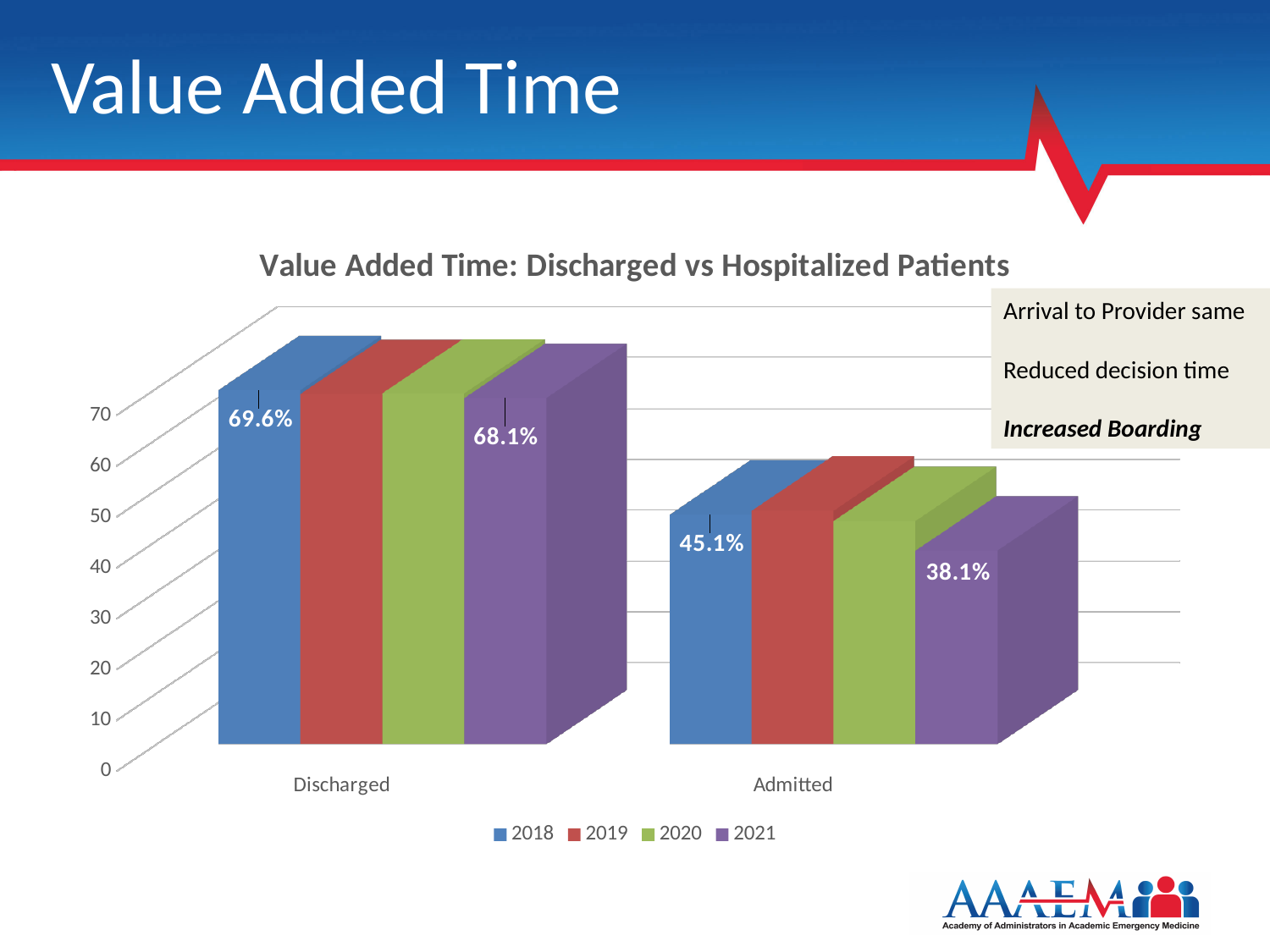
What is the difference between the 2018 and 2021 values for Admitted patients? 7.0% What is the value for 2018 in the Discharged category? 69.6% What kind of chart is shown on the slide? Bar chart Which category has the larger 2021 value, Discharged or Admitted? Discharged What is the value for 2018 in the Admitted category? 45.1% Is the 2019 value for Discharged greater or less than 50? greater What is the difference between the 2018 values for Discharged and Admitted patients? 24.5% What is the value for 2021 in the Admitted category? 38.1% How many series does the legend list? 4 What is the title of the chart? Value Added Time: Discharged vs Hospitalized Patients How many categories are shown on the x axis? 2 What is the value for 2021 in the Discharged category? 68.1%